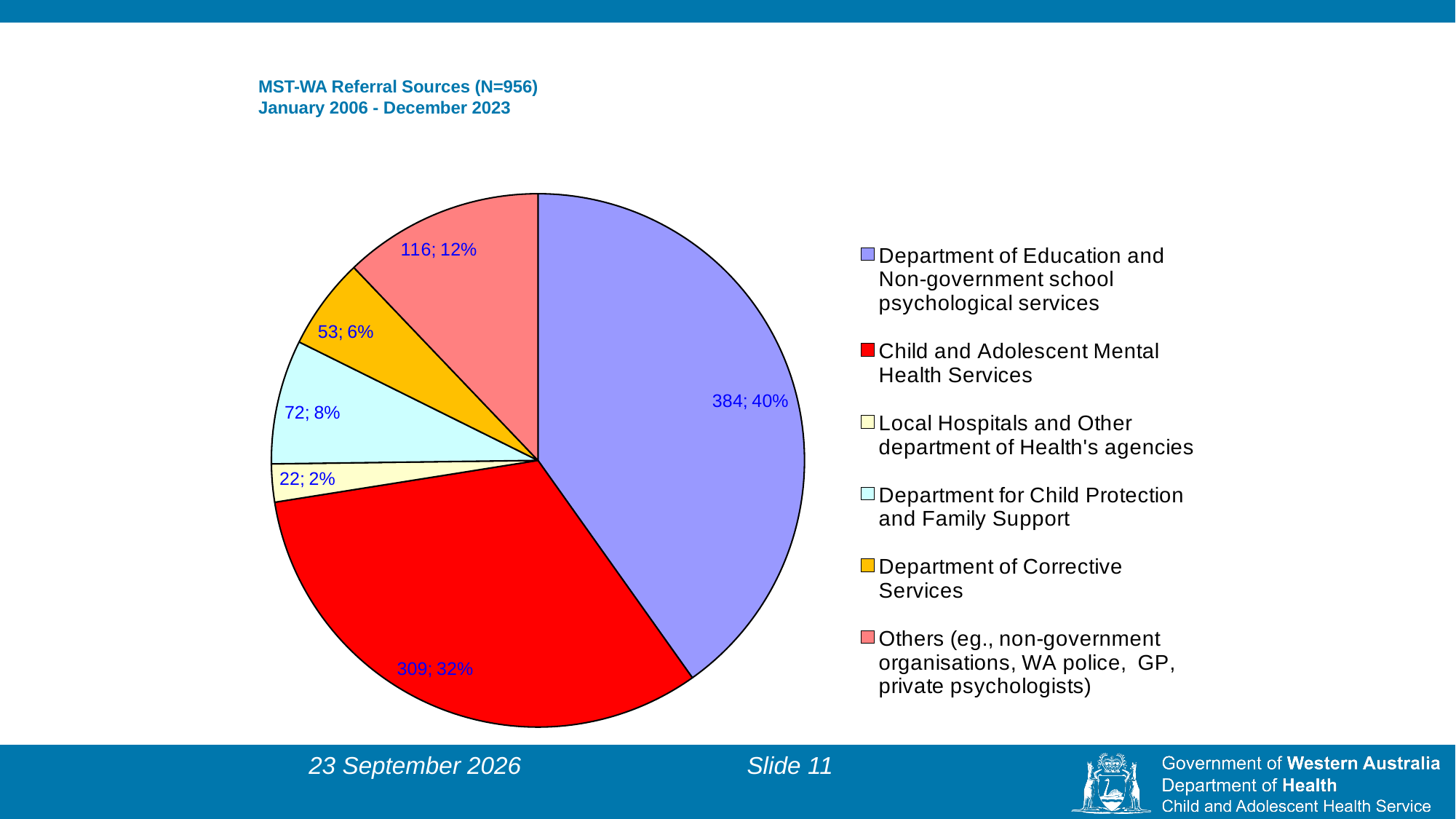
Which referral source has the smallest slice of the pie? Local Hospitals and Other department of Health's agencies What percentage of referrals came from the Department of Education and Non-government school psychological services? 40% How many referral source categories does the pie chart show? 6 What share of referrals came from the Department of Corrective Services? 6% What time period does the chart title say the referral data covers? January 2006 - December 2023 What is the difference in referral counts between the Department of Education and Non-government school psychological services and Child and Adolescent Mental Health Services? 75 How many referrals came from the Department for Child Protection and Family Support? 72 How many referrals came from Child and Adolescent Mental Health Services? 309 What is the total number of referrals (N) stated in the chart title? 956 What kind of chart is shown on the slide? Pie chart Which referral source has the largest slice of the pie? Department of Education and Non-government school psychological services Which has more referrals: Others or the Department of Corrective Services? Others